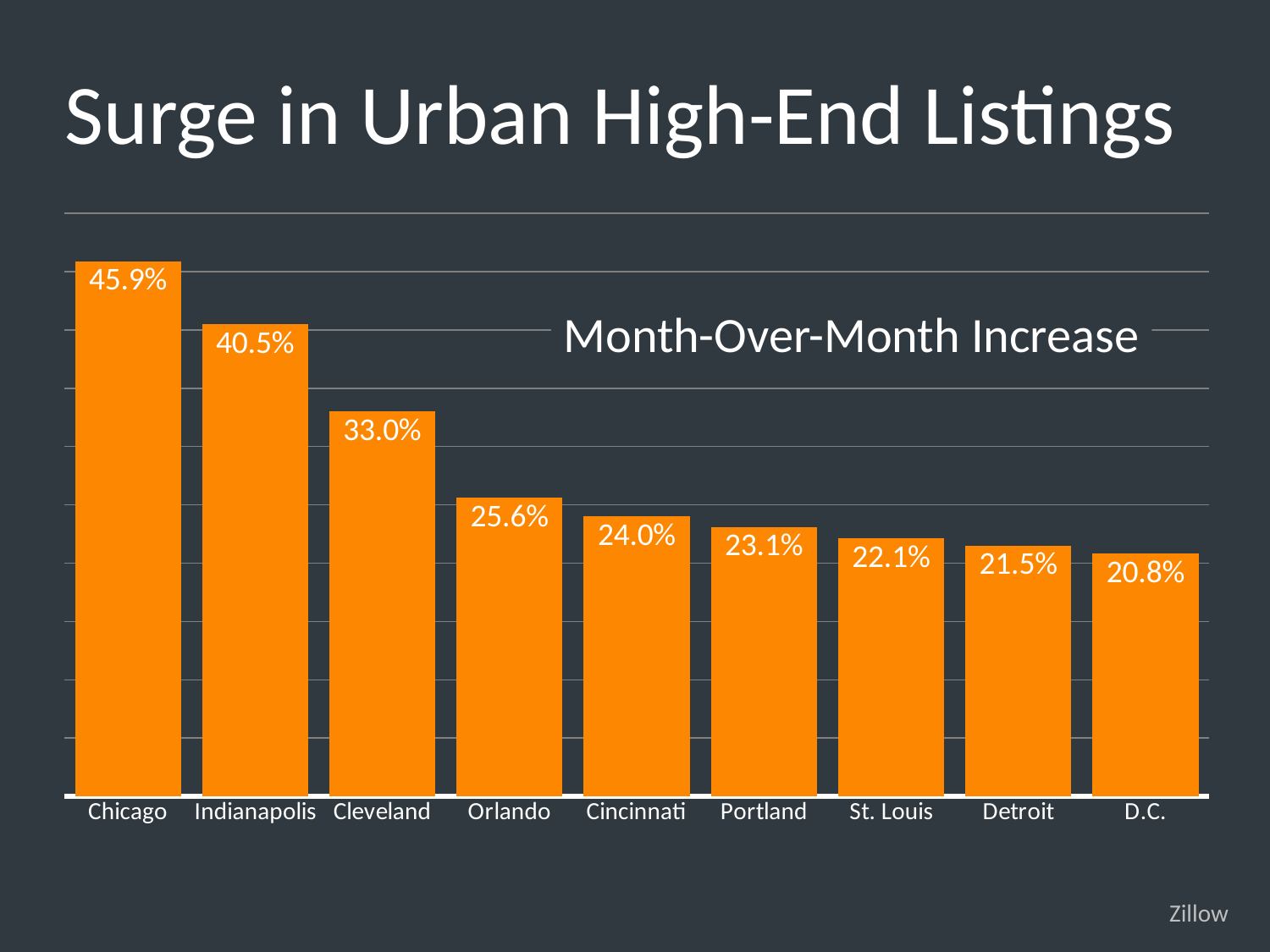
What is the month-over-month increase for Cleveland? 33.0% What is the value shown for St. Louis? 22.1% Which city has the highest month-over-month increase? Chicago What is the difference between the values for Orlando and Cincinnati? 1.6% What is the title of the slide? Surge in Urban High-End Listings Which has a larger month-over-month increase, Portland or Detroit? Portland What is the month-over-month increase for Chicago? 45.9% What kind of chart is shown on the slide? Bar chart Do the values rise or fall moving from left to right across the cities? Fall What is the difference between the values for Chicago and Indianapolis? 5.4% How many cities are shown in the chart? 9 Which city has the lowest month-over-month increase? D.C.